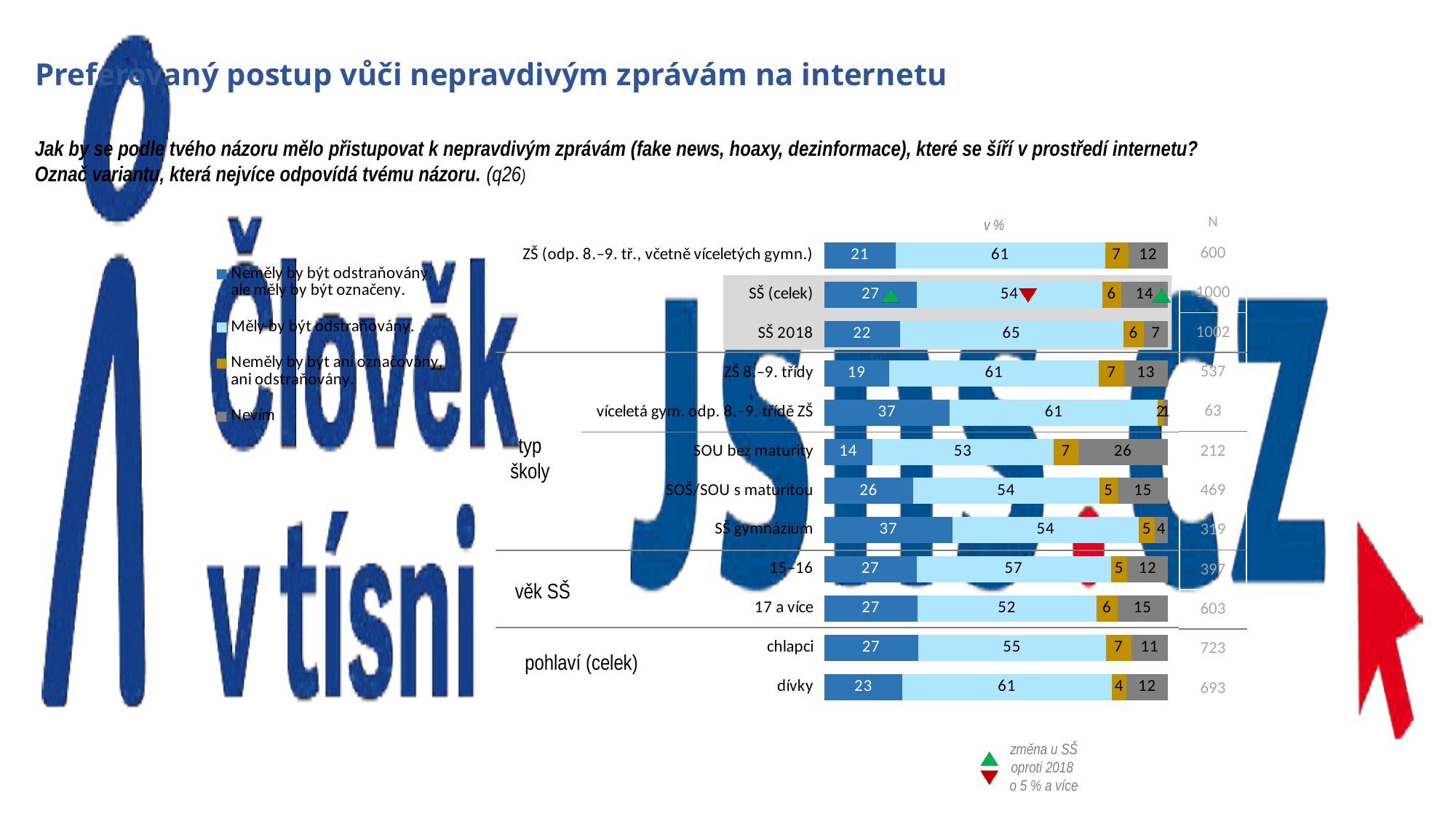
What is the N value shown for SŠ (celek)? 1000 What is the value of "Měly by být odstraňovány." for SŠ 2018? 65 What kind of chart is shown on the slide? stacked bar chart Which has a larger "Měly by být odstraňovány." value, chlapci or dívky? dívky Which category has the highest value for "Nevím"? SOU bez maturity What is the difference between the "Měly by být odstraňovány." values for SŠ 2018 and SŠ (celek)? 11 How many series does the legend list? 4 What is the total of the stacked bar for chlapci? 100 What is the value of "Neměly by být odstraňovány, ale měly by být označeny." for SŠ gymnázium? 37 What is the value of "Nevím" for SOU bez maturity? 26 What is the value of "Neměly by být ani označovány, ani odstraňovány." for dívky? 4 Which category has the lowest value for "Neměly by být odstraňovány, ale měly by být označeny."? SOU bez maturity